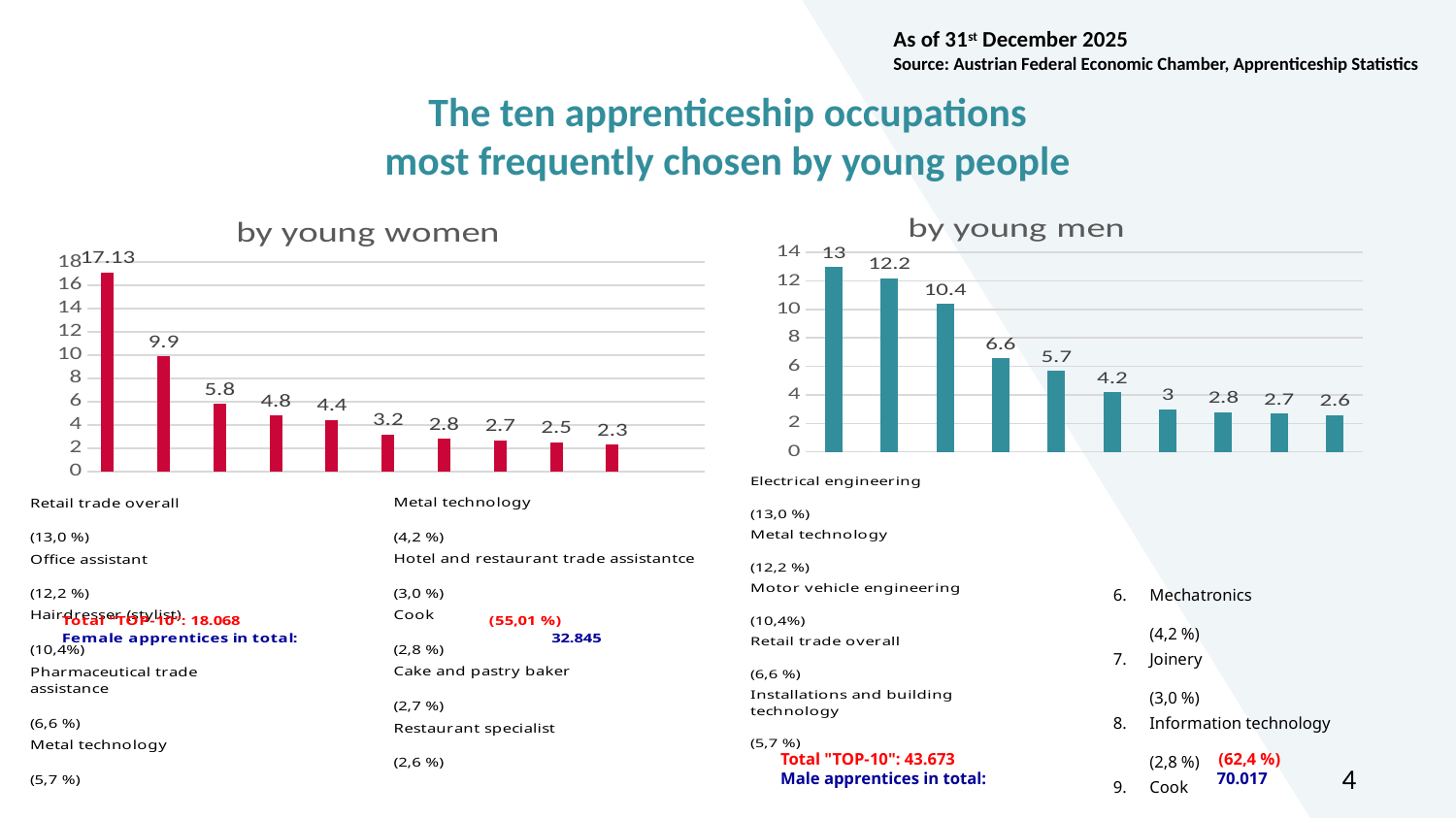
In the 'by young women' chart, what is the value of the tallest bar? 17.13 In the 'by young women' chart, do the values rise or fall from left to right? fall What type of chart is used for 'by young men'? bar chart In the 'by young women' chart, what is the value of the shortest bar? 2.3 In the 'by young men' chart, what is the value of the third bar from the left? 10.4 In the 'by young women' chart, what is the value of the second bar from the left? 9.9 In the 'by young men' chart, what is the value of the shortest bar? 2.6 In the 'by young men' chart, what is the difference between the second bar (12.2) and the fourth bar (6.6)? 5.6 In the 'by young women' chart, how many bars are plotted? 10 Which is larger: the tallest bar in the 'by young women' chart or the tallest bar in the 'by young men' chart? by young women (17.13) In the 'by young women' chart, what is the difference between the first bar (17.13) and the second bar (9.9)? 7.23 In the 'by young men' chart, what is the value of the tallest bar? 13